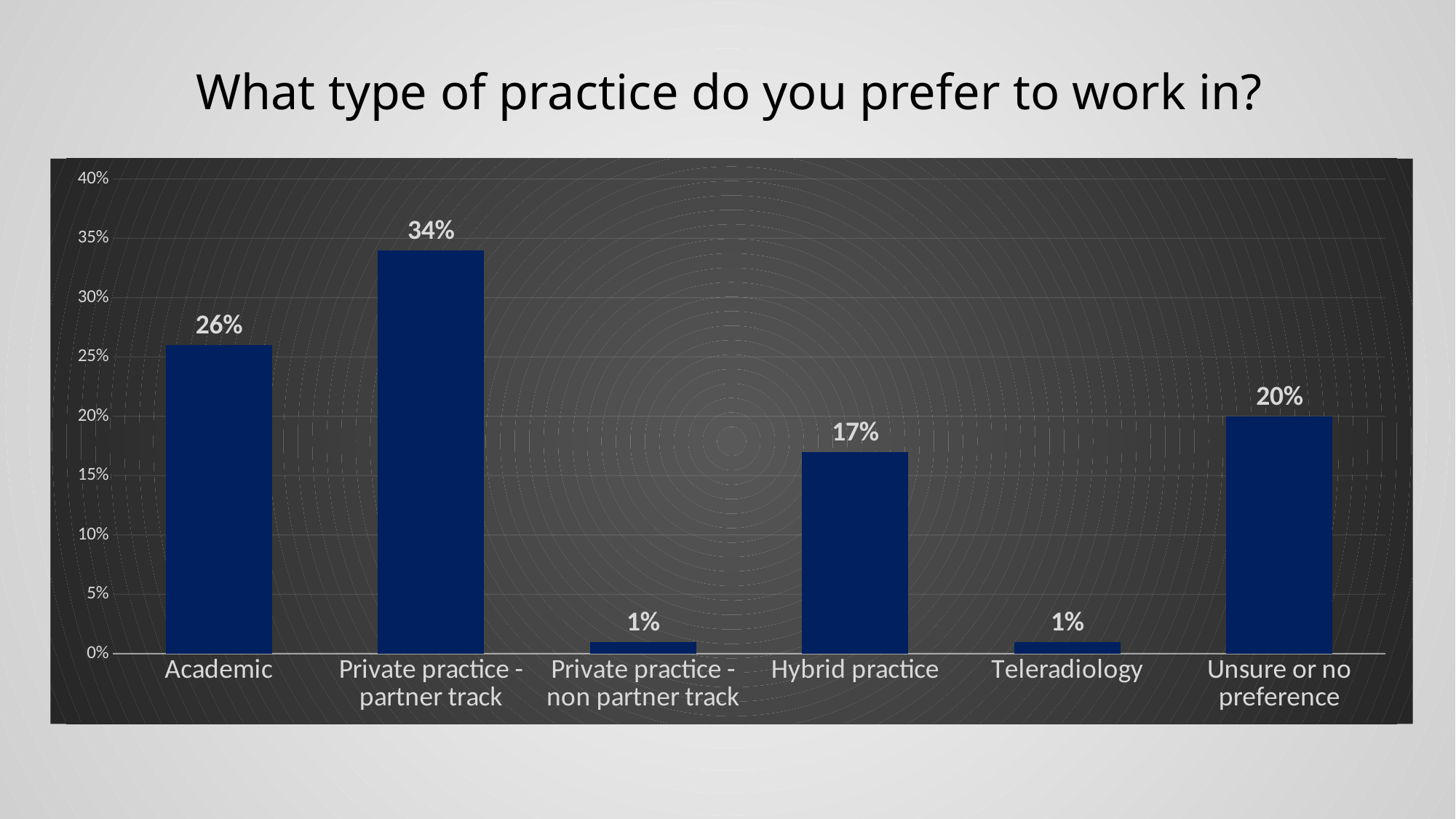
Is the value for Hybrid practice greater or less than 20%? less What is the value for Teleradiology? 1% Which is larger, Academic or Unsure or no preference? Academic Which category has the highest value? Private practice - partner track How many categories are shown on the x axis? 6 What is the difference between Private practice - partner track and Academic? 8% What is the value for Hybrid practice? 17% What is the value for Academic? 26% What is the value for Unsure or no preference? 20% What kind of chart is shown on the slide? bar chart What is the title of the chart? What type of practice do you prefer to work in? What is the value for Private practice - partner track? 34%